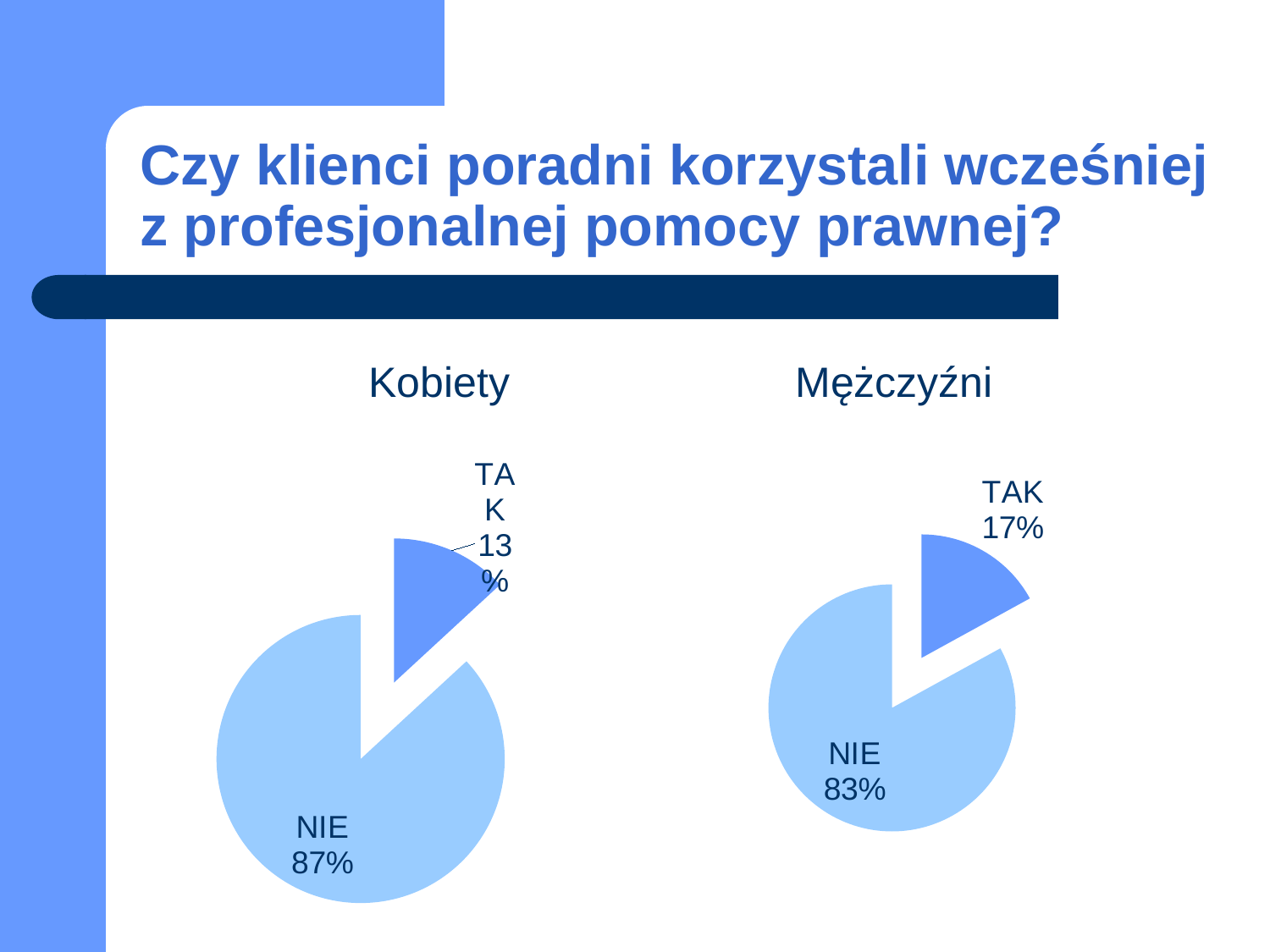
In the Kobiety chart, what is the difference between the NIE and TAK percentages? 74% In the Mężczyźni chart, what percentage is labelled TAK? 17% In the Mężczyźni chart, which slice is the smallest? TAK In the Kobiety chart, what percentage is labelled NIE? 87% In the Mężczyźni chart, what percentage is labelled NIE? 83% In the Kobiety chart, which slice is the largest? NIE Which is larger: the TAK share in the Kobiety chart or the TAK share in the Mężczyźni chart? Mężczyźni How many pie charts are shown on the slide? 2 How many slices does the Mężczyźni pie chart have? 2 In the Kobiety chart, what percentage is labelled TAK? 13% What kind of chart is the Kobiety chart? Pie chart What is the title of the chart on the right? Mężczyźni